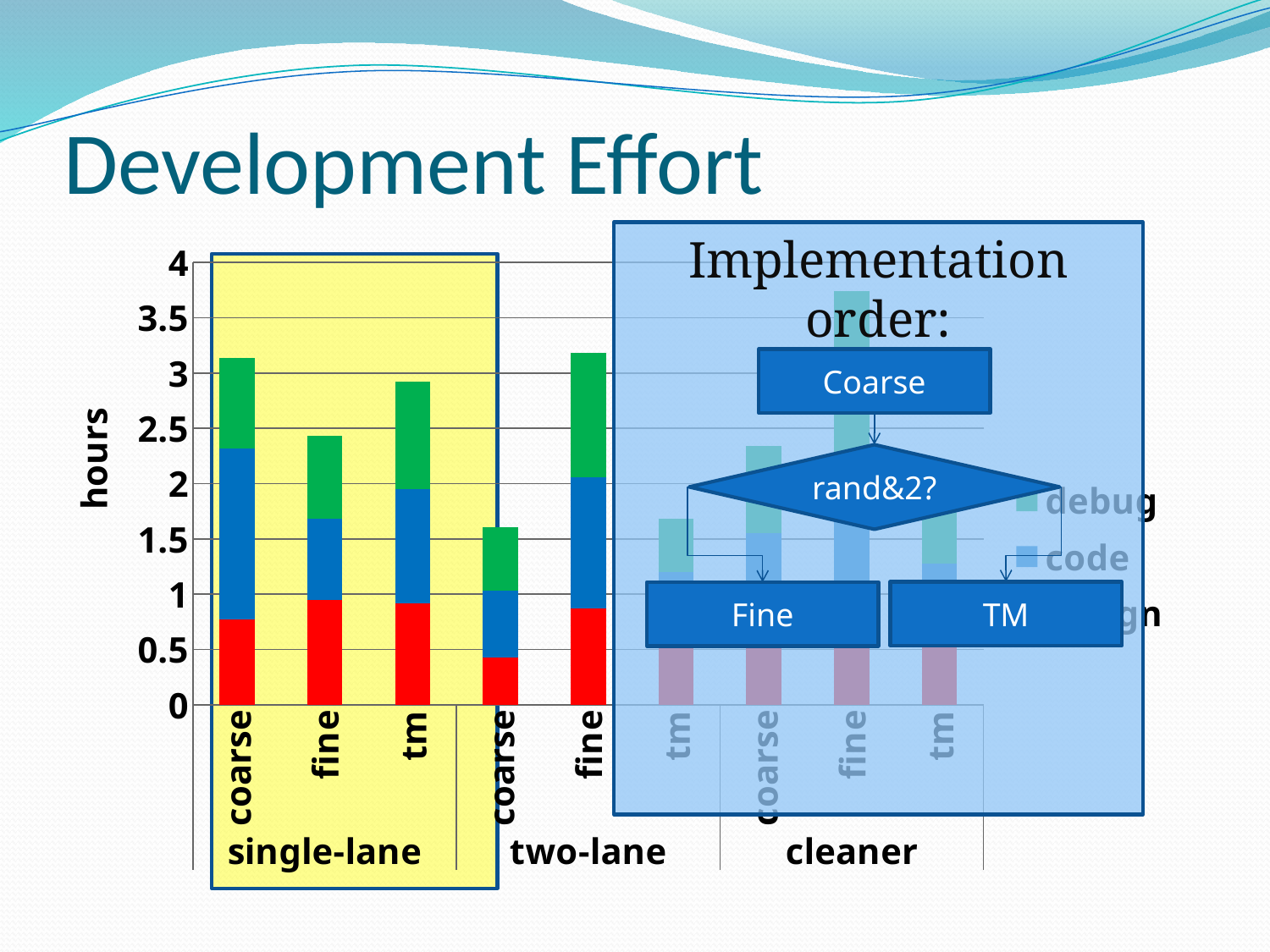
Is the total for the single-lane coarse bar greater or less than 3 hours? greater Which bar is taller, two-lane coarse or two-lane fine? two-lane fine Within the single-lane group, which category has the lowest total? fine Is the total for the single-lane tm bar greater or less than 2.5 hours? greater How many groups of categories are labelled along the horizontal axis? 3 What is the label of the vertical axis? hours Which bar is taller, single-lane coarse or single-lane fine? single-lane coarse Is the total for the two-lane coarse bar greater or less than 2 hours? less What kind of chart is shown on the slide? stacked bar chart What is the highest value shown on the vertical axis? 4